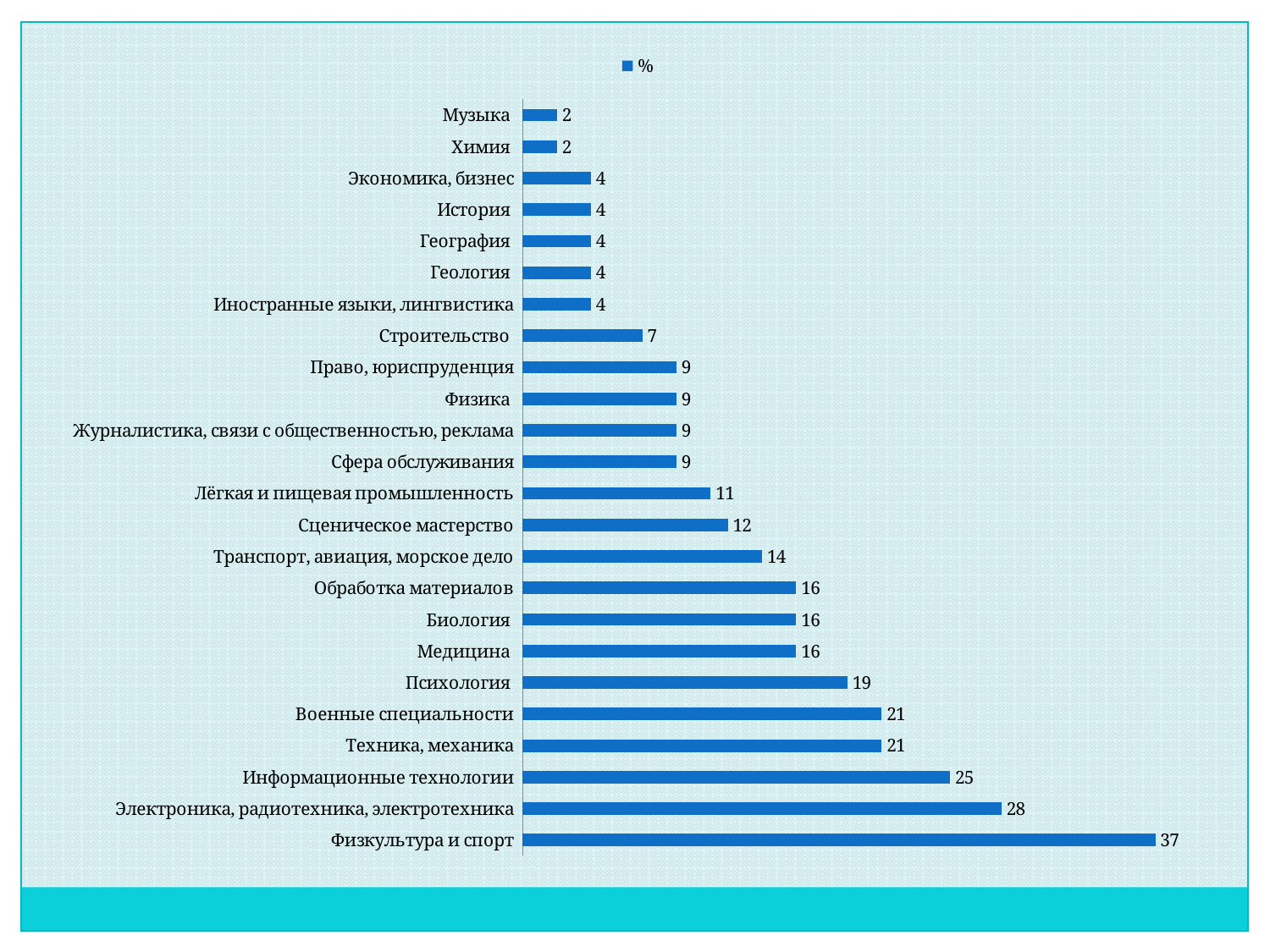
Which is larger, the value for Медицина or the value for Транспорт, авиация, морское дело? Медицина What is the value for Информационные технологии? 25 What kind of chart is shown on the slide? Bar chart Which is larger, the value for Лёгкая и пищевая промышленность or the value for Физика? Лёгкая и пищевая промышленность What is the value for Строительство? 7 What is the difference between the values for Физкультура и спорт and Электроника, радиотехника, электротехника? 9 What is the difference between the values for Информационные технологии and Сценическое мастерство? 13 How many categories are shown in the chart? 24 How many series does the legend list? 1 Which category has the highest value? Физкультура и спорт What is the value for Физкультура и спорт? 37 What is the value for Психология? 19